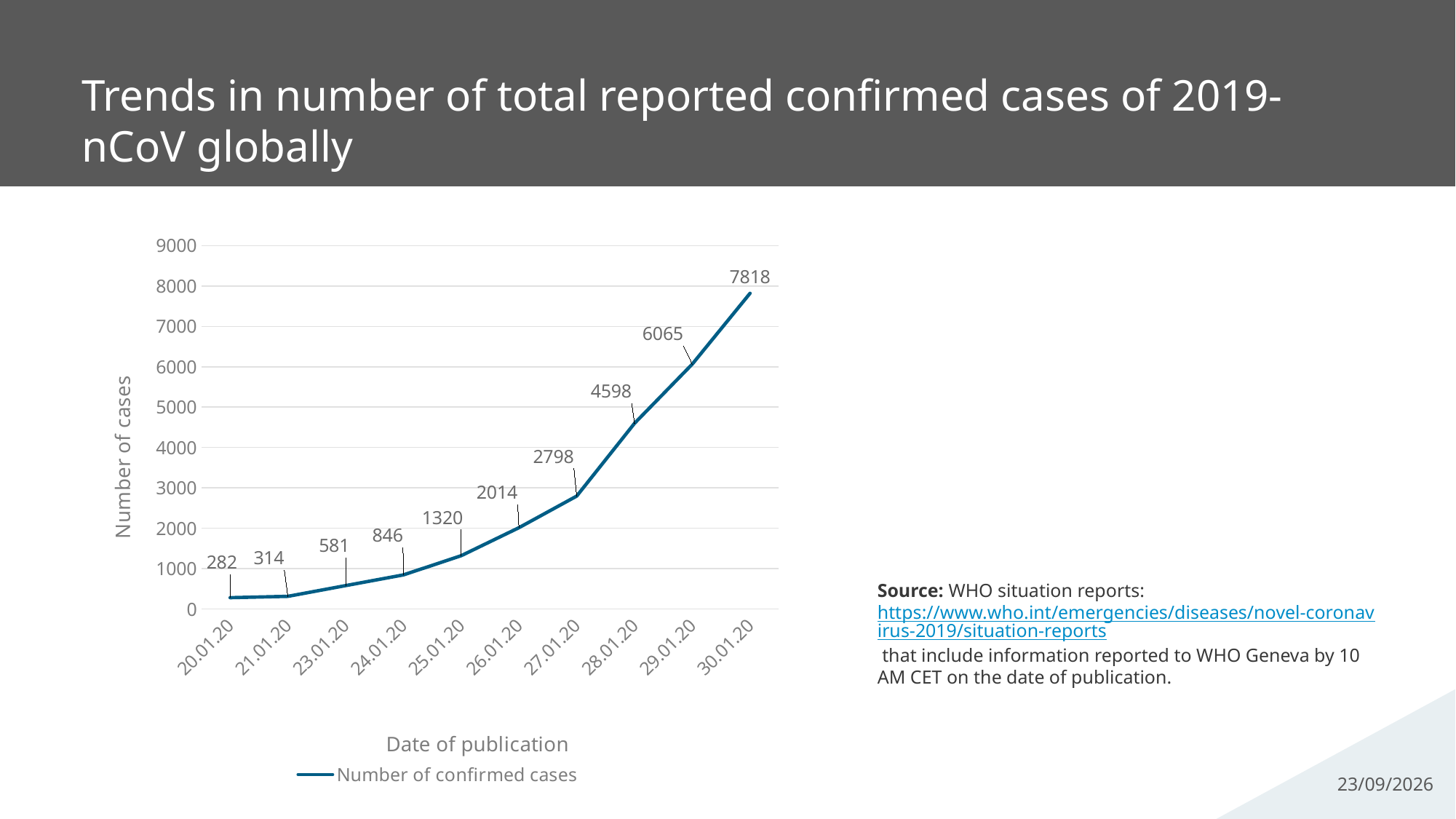
Which date has the highest number of confirmed cases? 30.01.20 What is the difference in confirmed cases between 27.01.20 and 26.01.20? 784 How many series does the legend list? 1 What is the number of confirmed cases on 20.01.20? 282 What is the difference in confirmed cases between 29.01.20 and 28.01.20? 1467 Do the number of confirmed cases rise or fall from 20.01.20 to 30.01.20? Rise How many dates are plotted on the x axis? 10 What kind of chart is shown on the slide? Line chart Which date has more confirmed cases, 23.01.20 or 24.01.20? 24.01.20 What is the number of confirmed cases on 30.01.20? 7818 What is the number of confirmed cases on 25.01.20? 1320 Which date has the lowest number of confirmed cases? 20.01.20